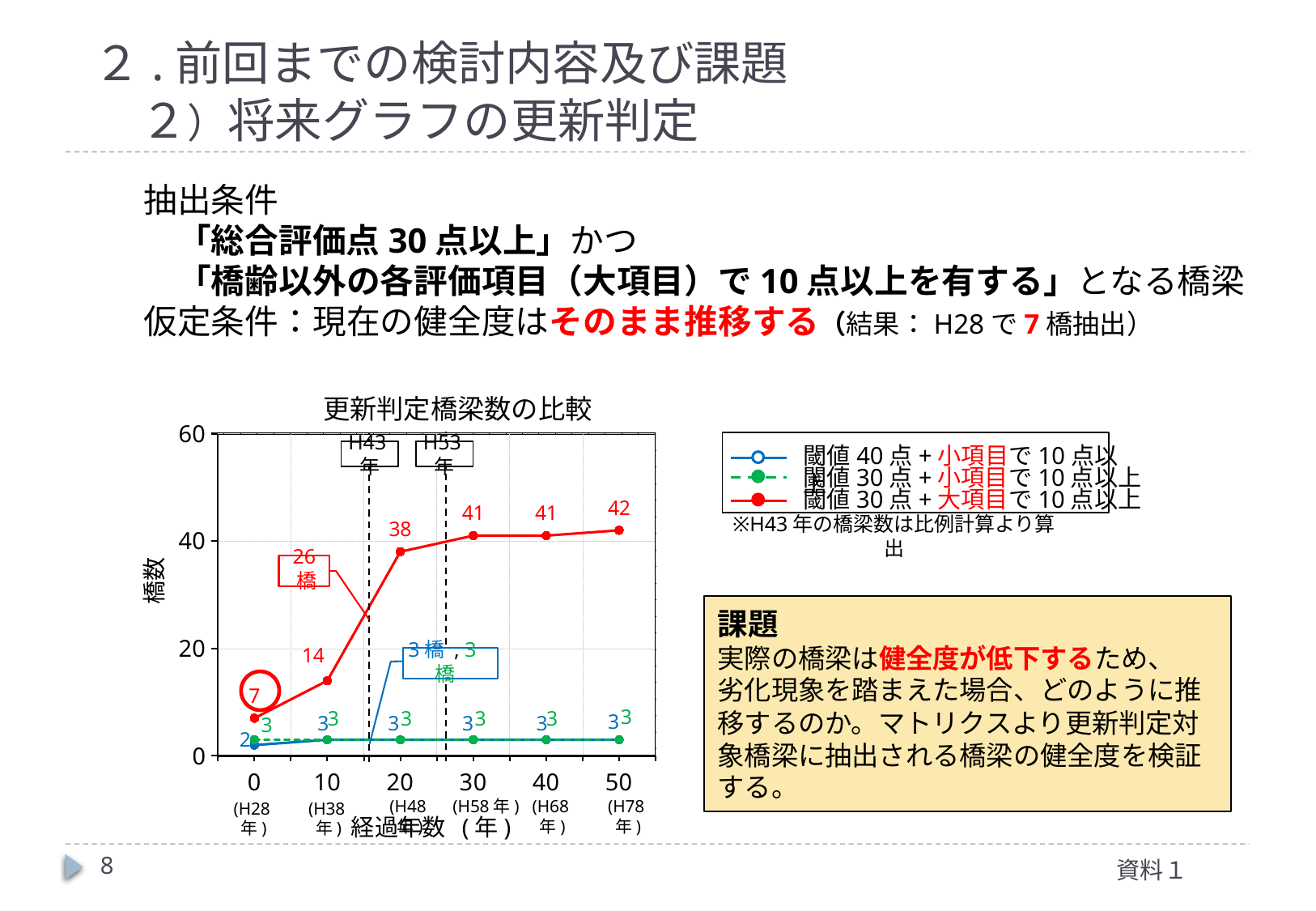
What type of chart is shown on the slide? line chart What is the value of the 閾値30点+小項目で10点以上 series at 経過年数 30 (H58年)? 3 What is the difference between the 閾値30点+大項目で10点以上 values at 経過年数 10 and 経過年数 0? 7 What is the value of the 閾値30点+大項目で10点以上 series at 経過年数 50 (H78年)? 42 What is the value of the 閾値40点+小項目で10点以上 series at 経過年数 0 (H28年)? 2 How many data points are plotted for the 閾値30点+大項目で10点以上 series? 6 At which 経過年数 does the 閾値30点+大項目で10点以上 series reach its highest value? 50 How many series does the chart legend list? 3 What is the value of the 閾値30点+大項目で10点以上 series at 経過年数 20 (H48年)? 38 Does the 閾値30点+大項目で10点以上 series rise or fall as 経過年数 increases? rise What is the title of the chart? 更新判定橋梁数の比較 What is the value of the 閾値30点+大項目で10点以上 series at 経過年数 0 (H28年)? 7